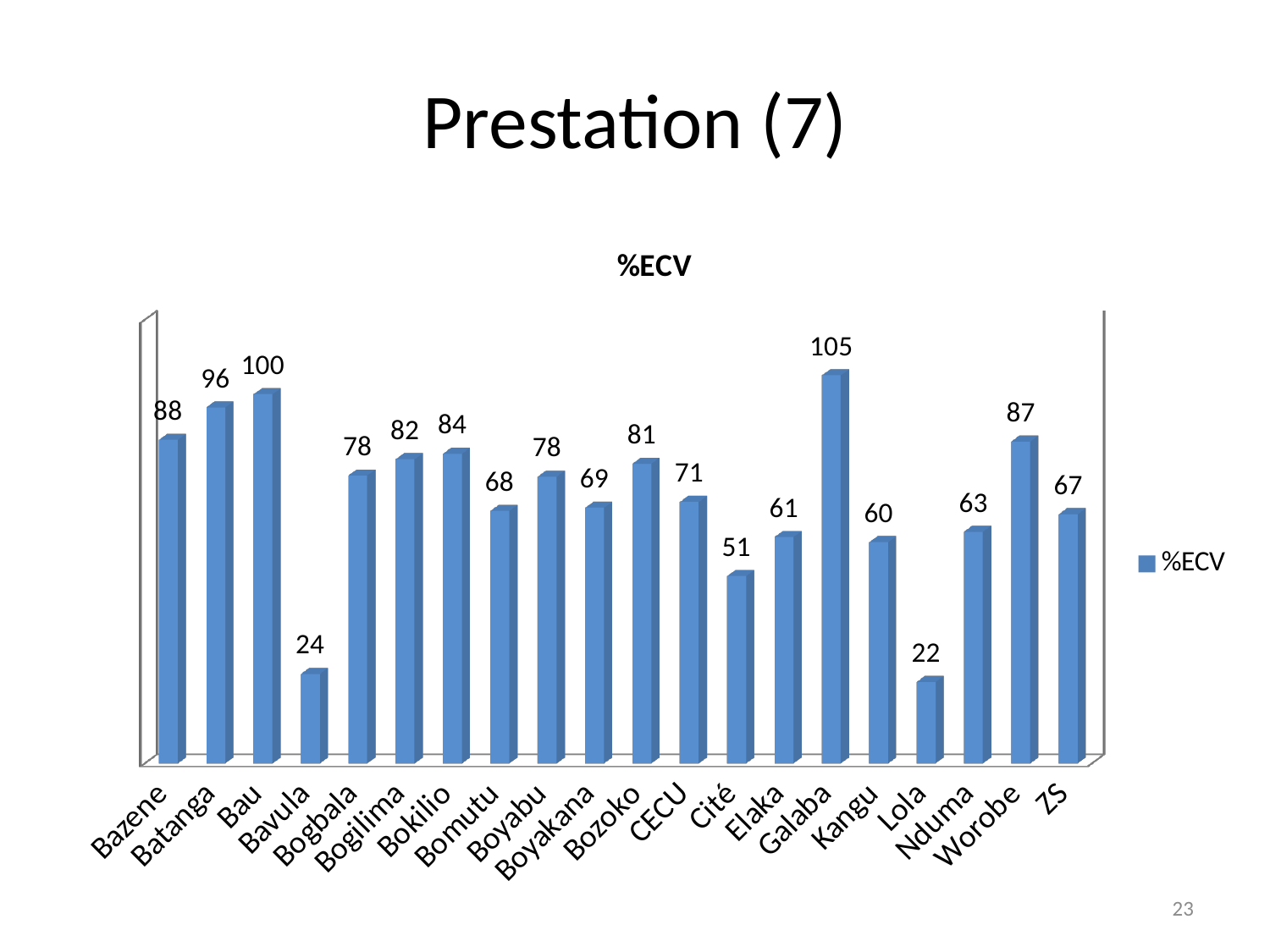
Which category has the highest %ECV value? Galaba What is the %ECV value for Worobe? 87 What is the %ECV value for ZS? 67 What is the difference between the %ECV values for Bau and Bavula? 76 How many series does the legend list? 1 What kind of chart is shown on the slide? Bar chart Which has a higher %ECV value, Batanga or Bokilio? Batanga How many categories are shown on the x axis of the chart? 20 What is the difference between the %ECV values for Galaba and Lola? 83 Which category has the lowest %ECV value? Lola What is the %ECV value for Galaba? 105 What is the %ECV value for Bavula? 24